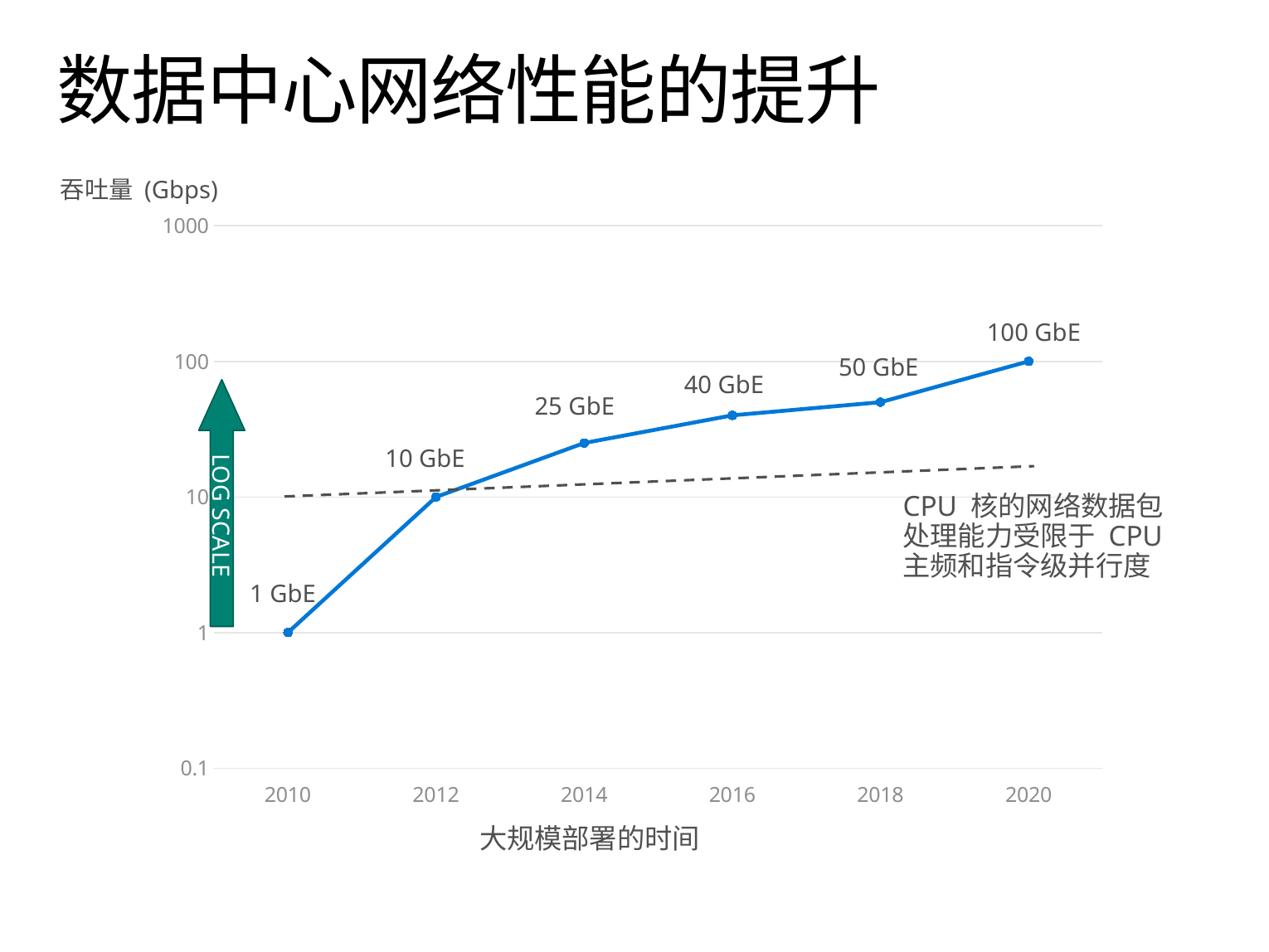
What kind of chart is shown on the slide? line chart What is the data label for the point at 2014? 25 GbE What is the data label for the point at 2010? 1 GbE What is the label on the green arrow next to the y axis? LOG SCALE What is the data label for the point at 2018? 50 GbE How many labelled data points are on the blue line? 6 Which year has the highest labelled throughput on the blue line? 2020 Which year has the lowest labelled throughput on the blue line? 2010 By how many GbE does the labelled value at 2020 exceed the labelled value at 2018? 50 GbE Is the value of the blue line at 2016 greater or less than 10? greater Does the blue line rise or fall from 2010 to 2020? rise Which is larger, the labelled value at 2016 or at 2014? 2016